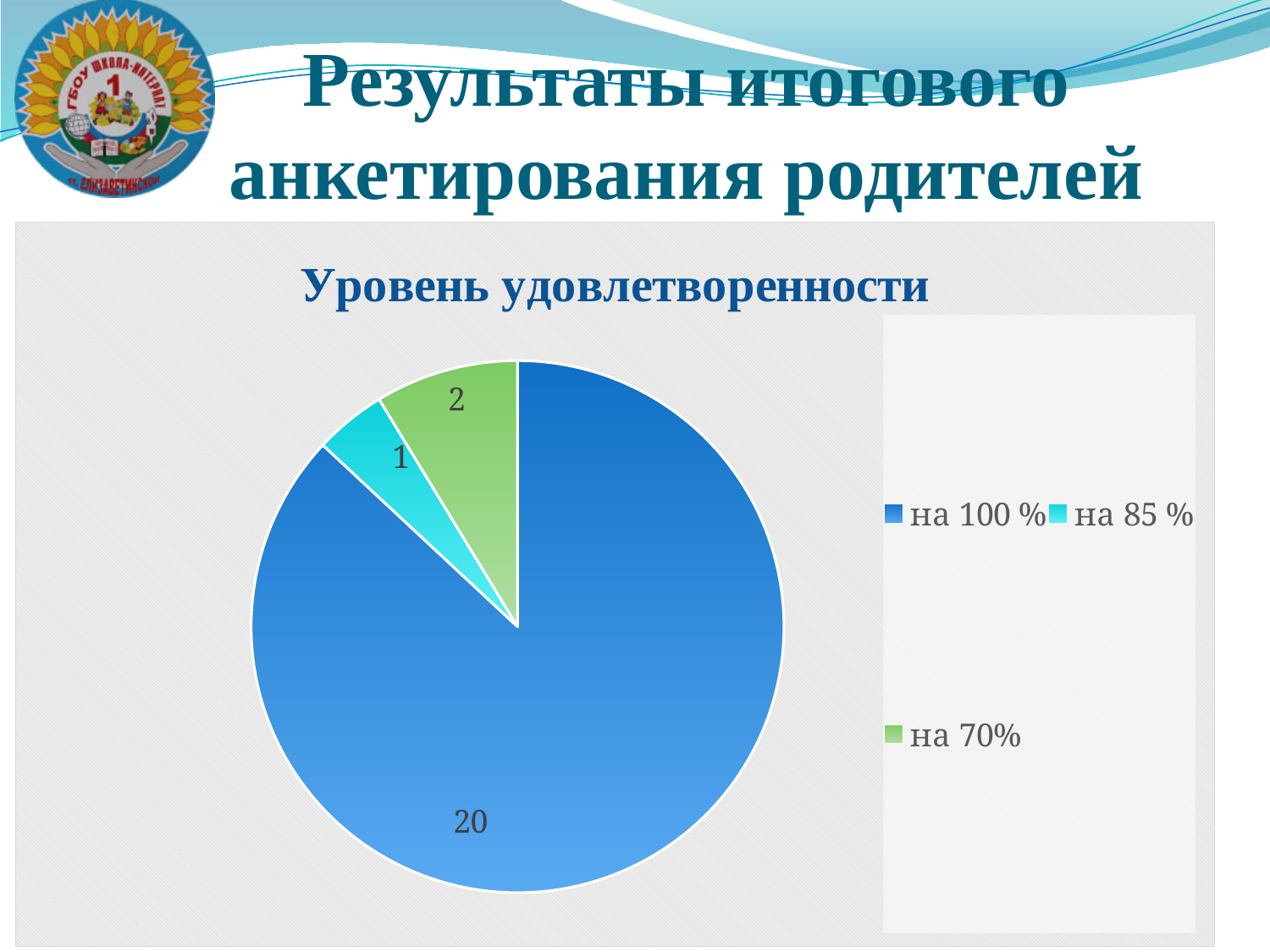
What is the difference between the values for "на 70%" and "на 85 %"? 1 Which is larger, the value for "на 70%" or the value for "на 85 %"? на 70% How many slices does the pie chart have? 3 What is the value for the slice "на 85 %"? 1 What is the value for the slice "на 100 %"? 20 What type of chart is shown on the slide? pie chart Which category has the largest slice of the pie? на 100 % What is the value for the slice "на 70%"? 2 Which category has the smallest slice of the pie? на 85 % What is the title of the chart? Уровень удовлетворенности What is the total of all the slice values in the pie chart? 23 What is the difference between the values for "на 100 %" and "на 70%"? 18